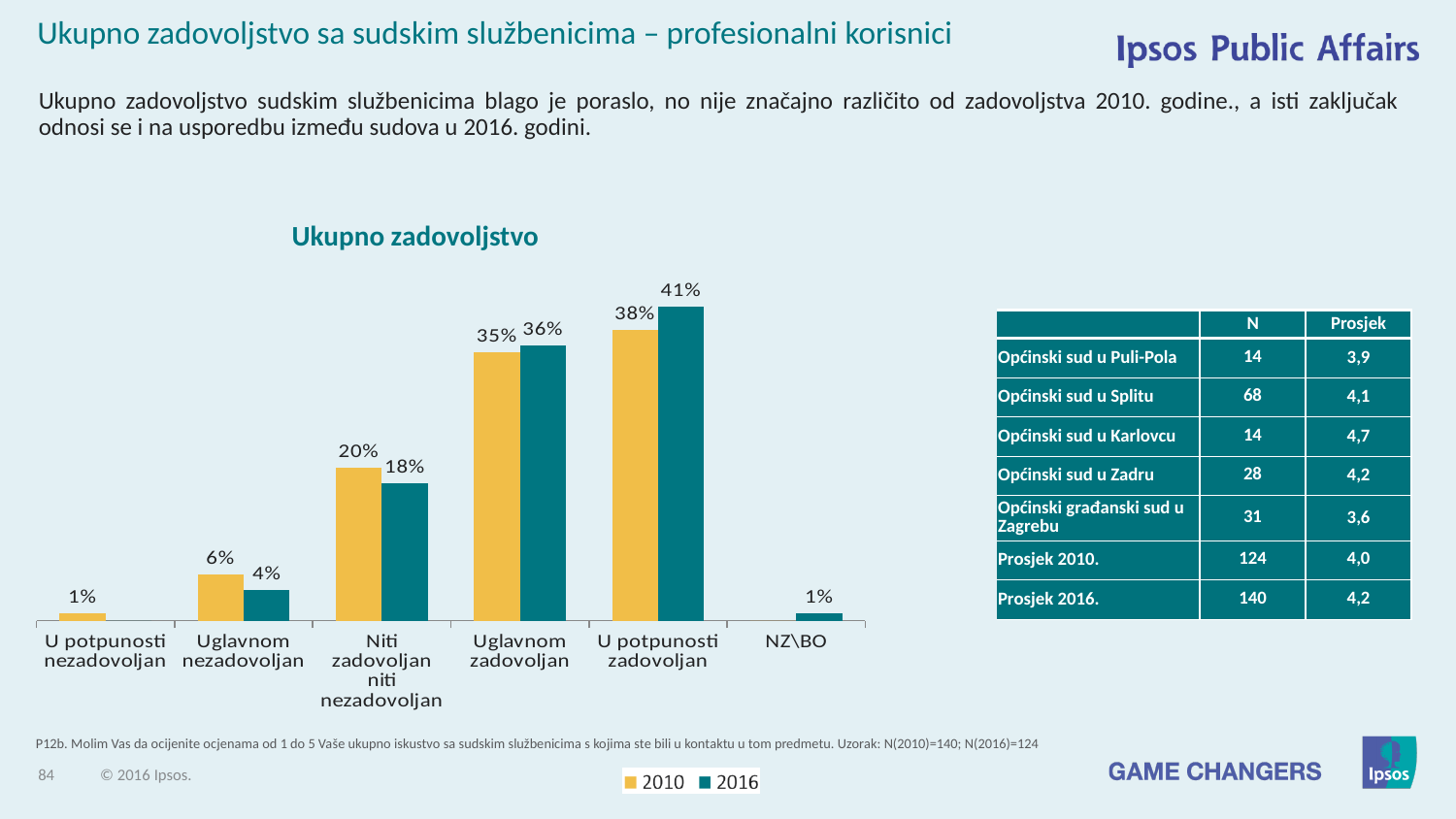
How many categories are shown on the x axis of the 'Ukupno zadovoljstvo' chart? 6 What is the 2010 value for 'Uglavnom nezadovoljan' in the 'Ukupno zadovoljstvo' chart? 6% In the 'Ukupno zadovoljstvo' chart, which is larger for 'Niti zadovoljan niti nezadovoljan': the 2010 value or the 2016 value? 2010 In the 'Ukupno zadovoljstvo' chart, what is the difference between the 2016 and 2010 values for 'U potpunosti zadovoljan'? 3% How many series does the legend of the 'Ukupno zadovoljstvo' chart list? 2 What type of chart is 'Ukupno zadovoljstvo'? Bar chart What is the 2010 value for 'Uglavnom zadovoljan' in the 'Ukupno zadovoljstvo' chart? 35% What is the 2016 value for 'U potpunosti zadovoljan' in the 'Ukupno zadovoljstvo' chart? 41% In the 'Ukupno zadovoljstvo' chart, what is the difference between the 2010 and 2016 values for 'Uglavnom nezadovoljan'? 2% Which category has the highest 2016 value in the 'Ukupno zadovoljstvo' chart? U potpunosti zadovoljan What is the 2016 value for 'Niti zadovoljan niti nezadovoljan' in the 'Ukupno zadovoljstvo' chart? 18%